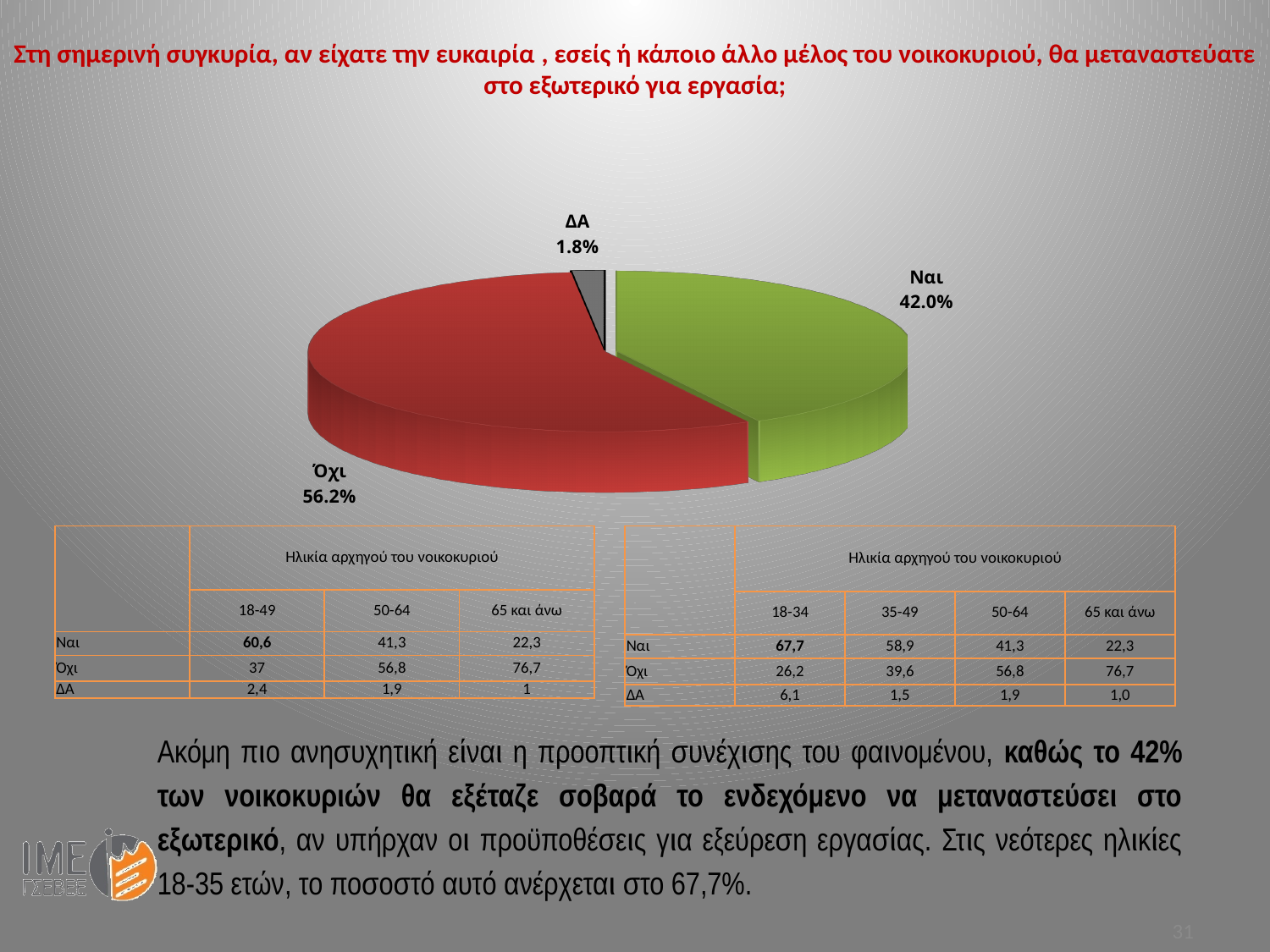
What is the value of the Ναι slice in the pie chart? 42.0% What share of the pie does the Ναι slice represent? 42.0% What is the value of the Όχι slice in the pie chart? 56.2% What colour is the Όχι slice in the pie chart? red What colour is the Ναι slice in the pie chart? green What kind of chart is shown on the slide? pie chart What is the difference between the Όχι and Ναι slices in the pie chart? 14.2% Which is larger in the pie chart, Ναι or Όχι? Όχι How many slices does the pie chart have? 3 Which slice of the pie chart is the smallest? ΔΑ What is the value of the ΔΑ slice in the pie chart? 1.8% Which slice of the pie chart is the largest? Όχι